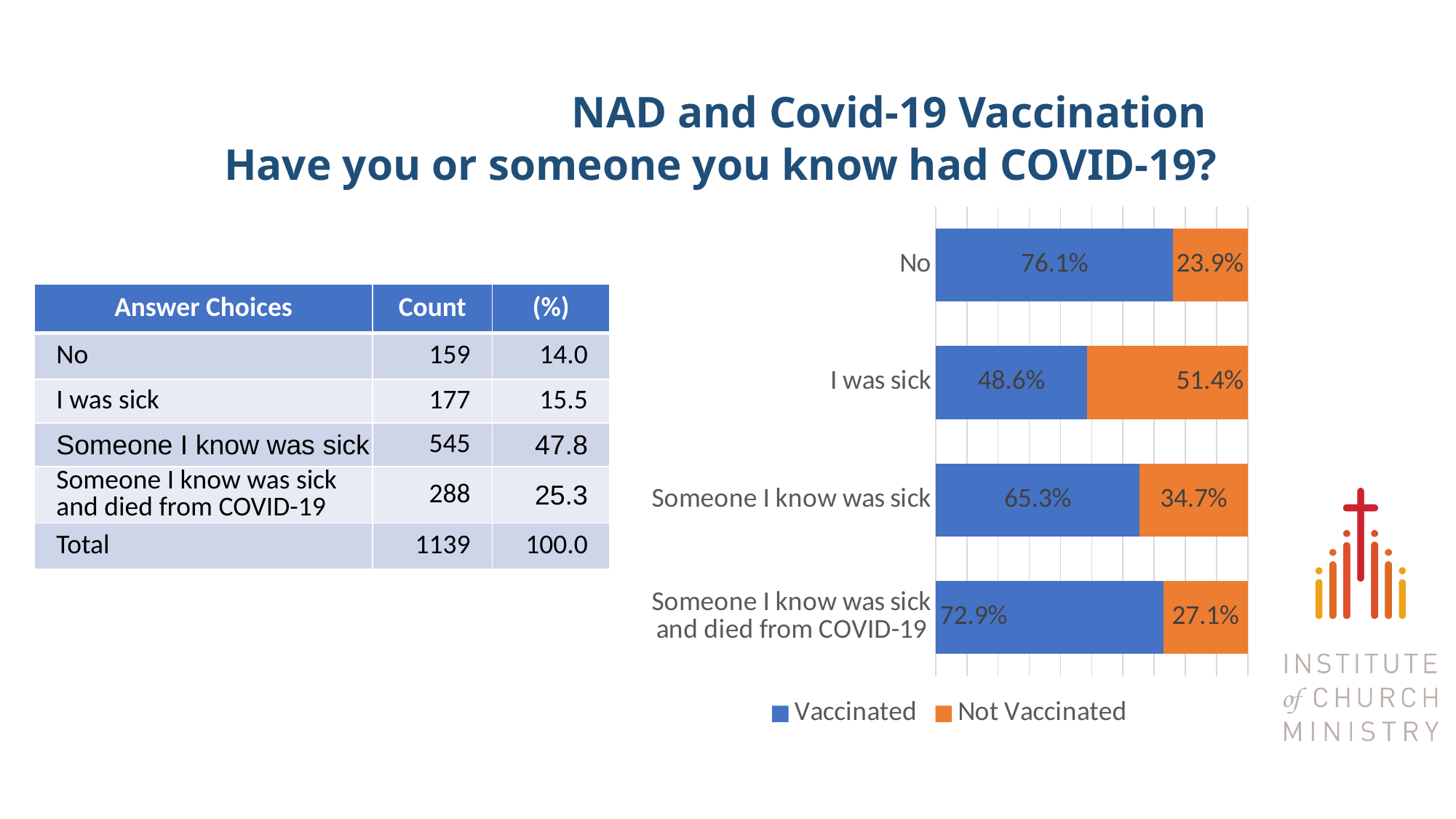
How many categories are shown in the chart? 4 What is the difference between the Vaccinated and Not Vaccinated values for "No"? 52.2% What is the Not Vaccinated value for "I was sick"? 51.4% What is the Vaccinated value for "Someone I know was sick"? 65.3% Which category has the highest Vaccinated share? No What kind of chart is shown on the slide? Stacked bar chart Which category has the lowest Vaccinated share? I was sick Is the Vaccinated value larger for "Someone I know was sick" or for "Someone I know was sick and died from COVID-19"? Someone I know was sick and died from COVID-19 Which category has the highest Not Vaccinated share? I was sick What is the Not Vaccinated value for "Someone I know was sick and died from COVID-19"? 27.1% How many series does the legend list? 2 What is the Vaccinated value for the "No" category? 76.1%